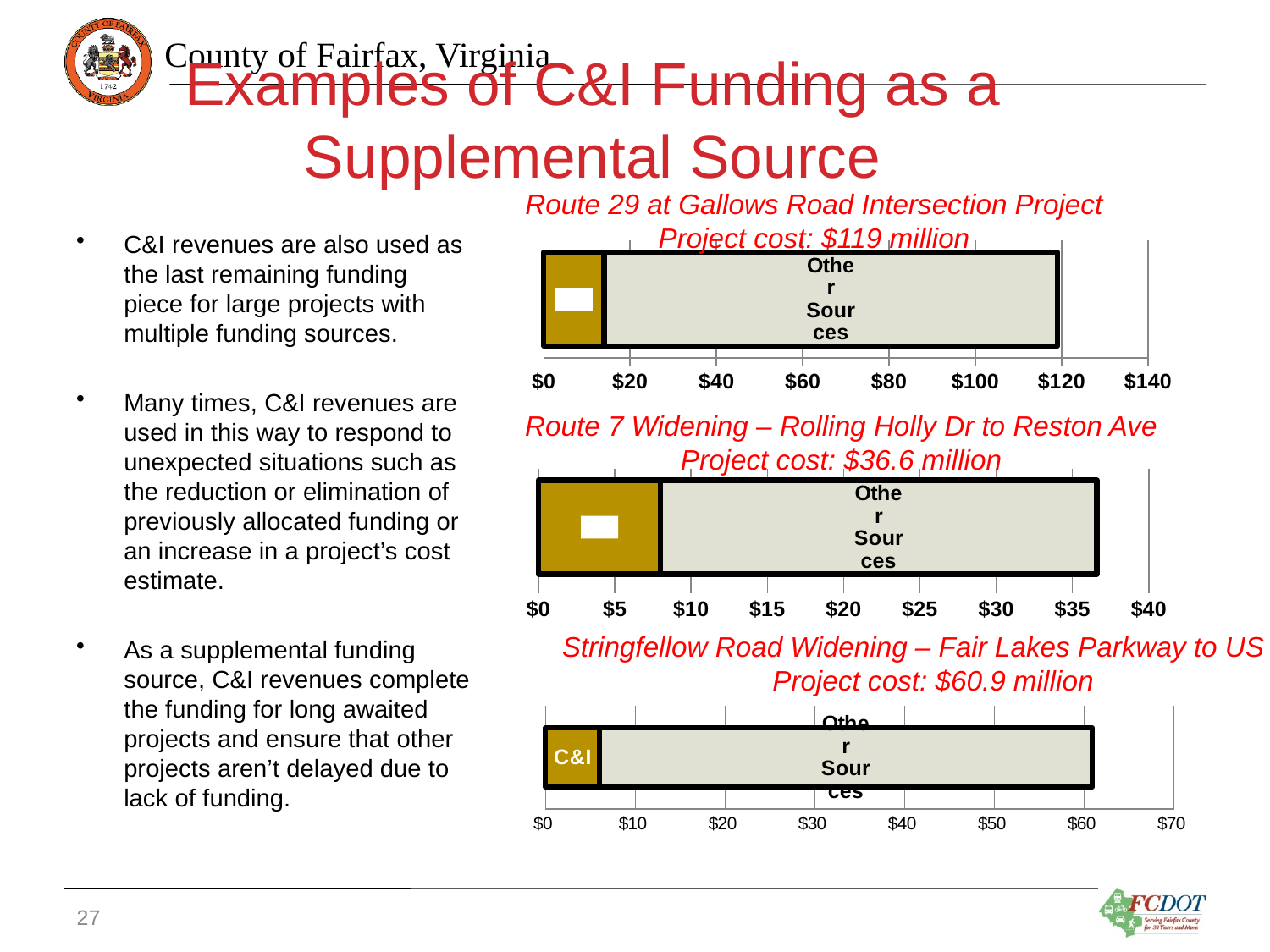
In the Stringfellow Road Widening – Fair Lakes Parkway to US chart, does the full stacked bar extend greater or less than $50? greater In the Route 7 Widening – Rolling Holly Dr to Reston Ave chart, is the C&I segment greater or less than $10? less How many segments make up the stacked bar in the Stringfellow Road Widening – Fair Lakes Parkway to US chart? 2 What project cost is stated in the title of the Route 7 Widening – Rolling Holly Dr to Reston Ave chart? $36.6 million What kind of chart is used for the Route 29 at Gallows Road Intersection Project? Bar chart What project cost is stated in the title of the Route 29 at Gallows Road Intersection Project chart? $119 million In the Route 29 at Gallows Road Intersection Project chart, which segment is larger, C&I or Other Sources? Other Sources In the Route 7 Widening – Rolling Holly Dr to Reston Ave chart, does the full stacked bar extend greater or less than $30? greater In the Route 7 Widening – Rolling Holly Dr to Reston Ave chart, which segment is larger, C&I or Other Sources? Other Sources